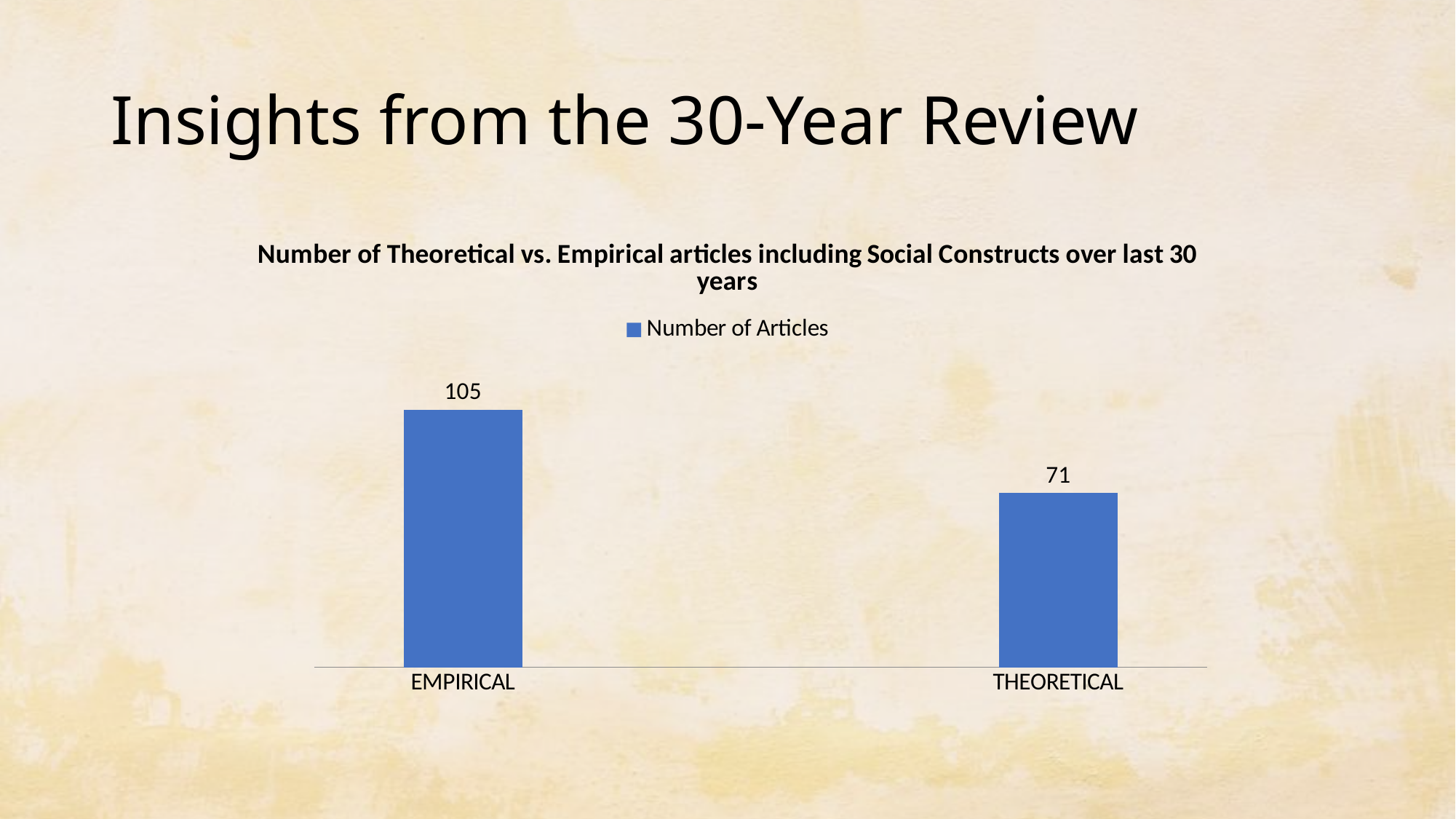
Which category has the highest number of articles? EMPIRICAL What is the total number of articles across both categories? 176 What is the number of articles for THEORETICAL? 71 What kind of chart is shown on the slide? Bar chart How many categories are shown in the chart? 2 What is the title of the chart? Number of Theoretical vs. Empirical articles including Social Constructs over last 30 years What is the difference between the number of EMPIRICAL and THEORETICAL articles? 34 How many series does the legend list? 1 What series name is shown in the chart legend? Number of Articles Which is larger, the number of EMPIRICAL articles or the number of THEORETICAL articles? EMPIRICAL What is the number of articles for EMPIRICAL? 105 Which category has the lowest number of articles? THEORETICAL